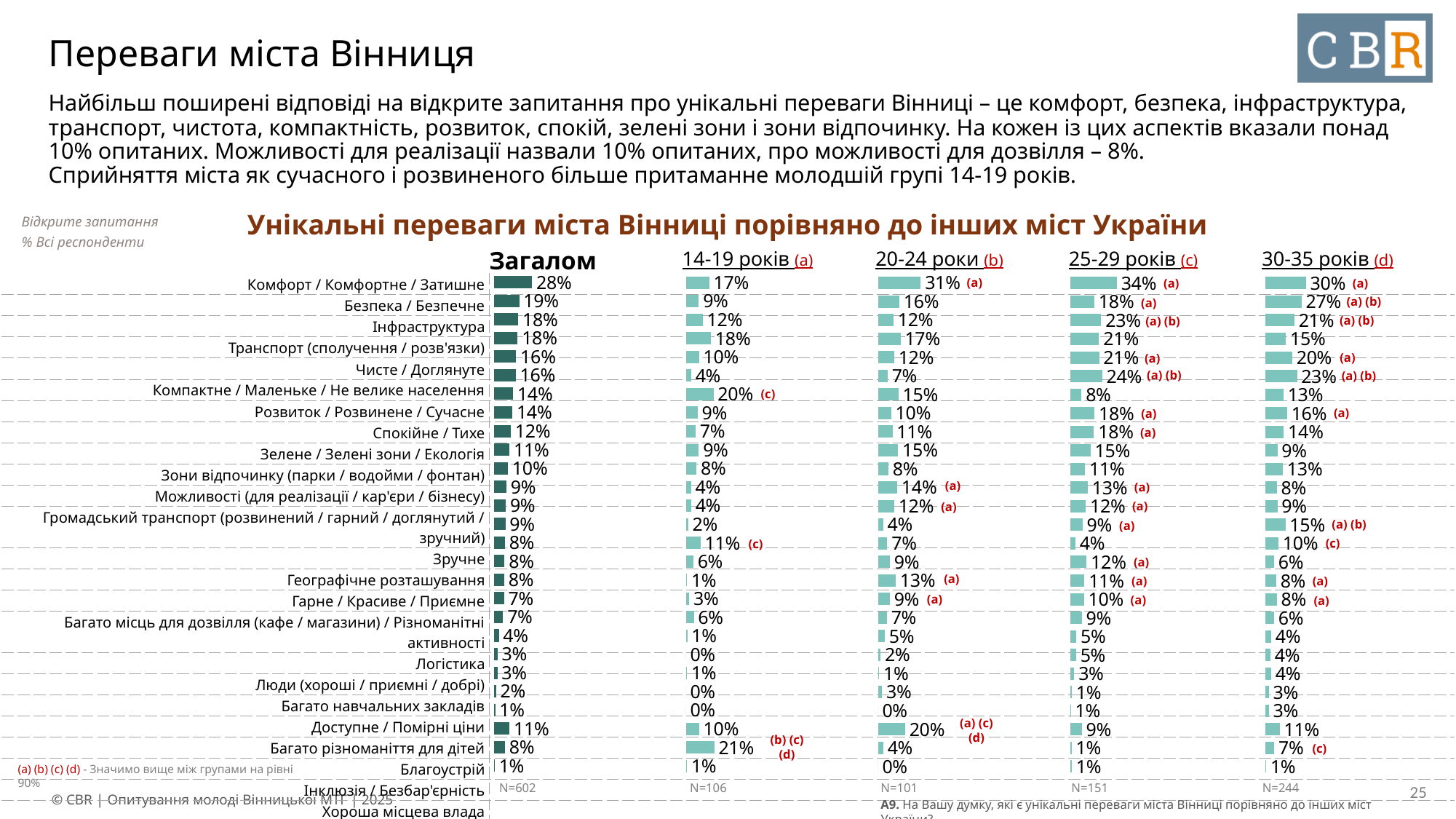
What is the value for Комфорт / Комфортне / Затишне in the 25-29 років column? 34% Which category has the highest value in the Загалом column? Комфорт / Комфортне / Затишне What is the value for Інфраструктура in the 25-29 років column? 23% What is the value for Безпека / Безпечне in the Загалом column? 19% What is the sample size (N) shown under the Загалом column? N=602 For Безпека / Безпечне, which is larger: the value for 30-35 років or for 14-19 років? 30-35 років How many age-group columns are shown in addition to Загалом? 4 Which age group has the highest value for Комфорт / Комфортне / Затишне? 25-29 років What kind of chart is used on the slide to show the unique advantages of Vinnytsia? bar chart What is the title of the chart? Унікальні переваги міста Вінниці порівняно до інших міст України In the Загалом column, what percentage is shown for Комфорт / Комфортне / Затишне? 28% What is the difference between the Комфорт / Комфортне / Затишне values for 25-29 років and 14-19 років? 17 percentage points